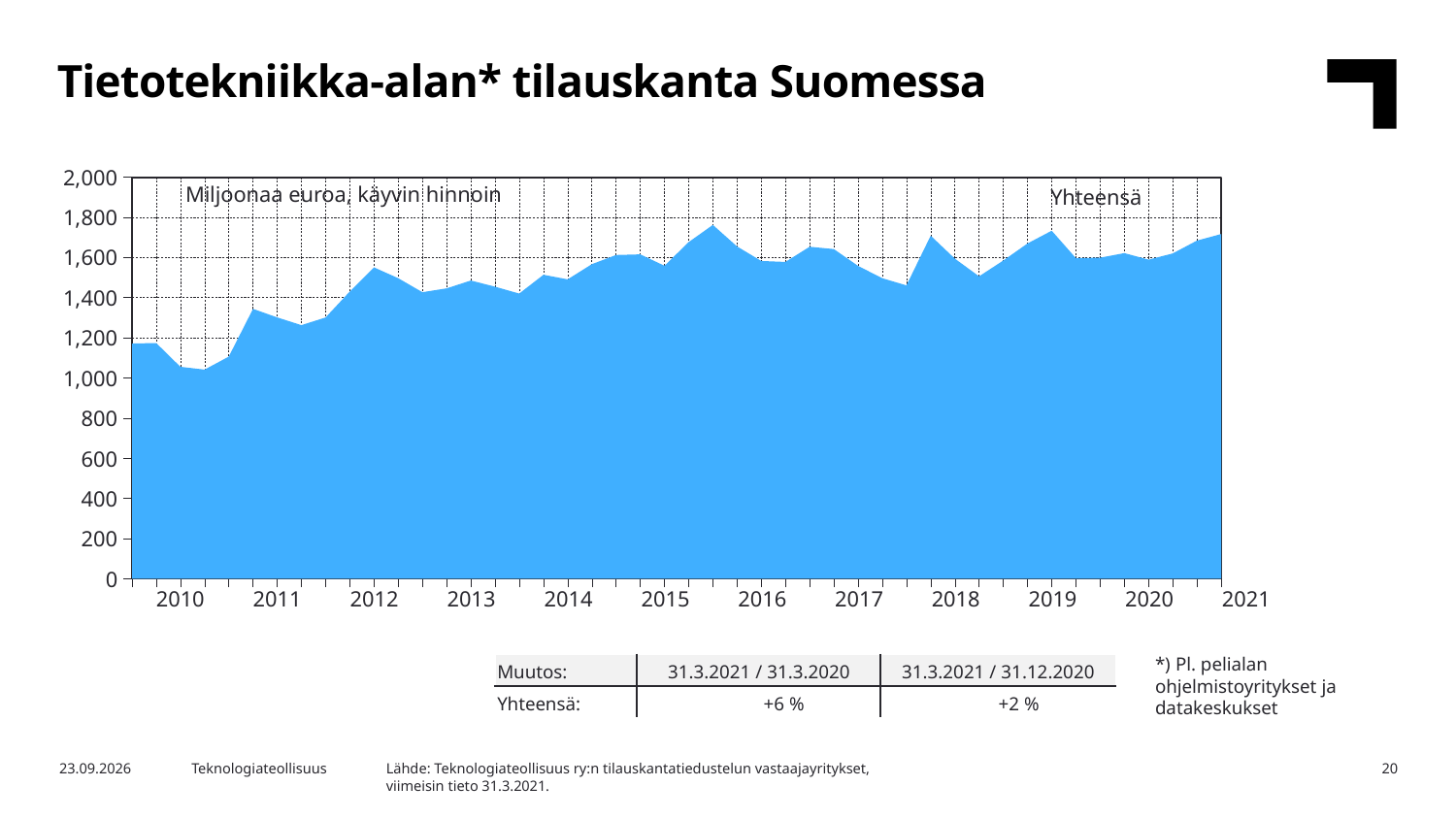
What is the series label shown in the upper right of the chart area? Yhteensä Is the value at the start of 2013 greater or less than 1,200? greater Is the peak value in 2015 greater or less than 1,600? greater Is the value at the start of 2010 greater or less than 1,400? less How many years are labelled on the x axis of the chart? 12 What kind of chart is shown on the slide? area chart Overall, do the values rise or fall from 2010 to 2021? rise In which year does the chart reach its lowest value? 2010 What is the highest value shown on the y axis of the chart? 2,000 What unit label is shown in the upper left of the chart area? Miljoonaa euroa, käyvin hinnoin Which is larger, the value at the start of 2010 or the value at the end of the series in 2021? 2021